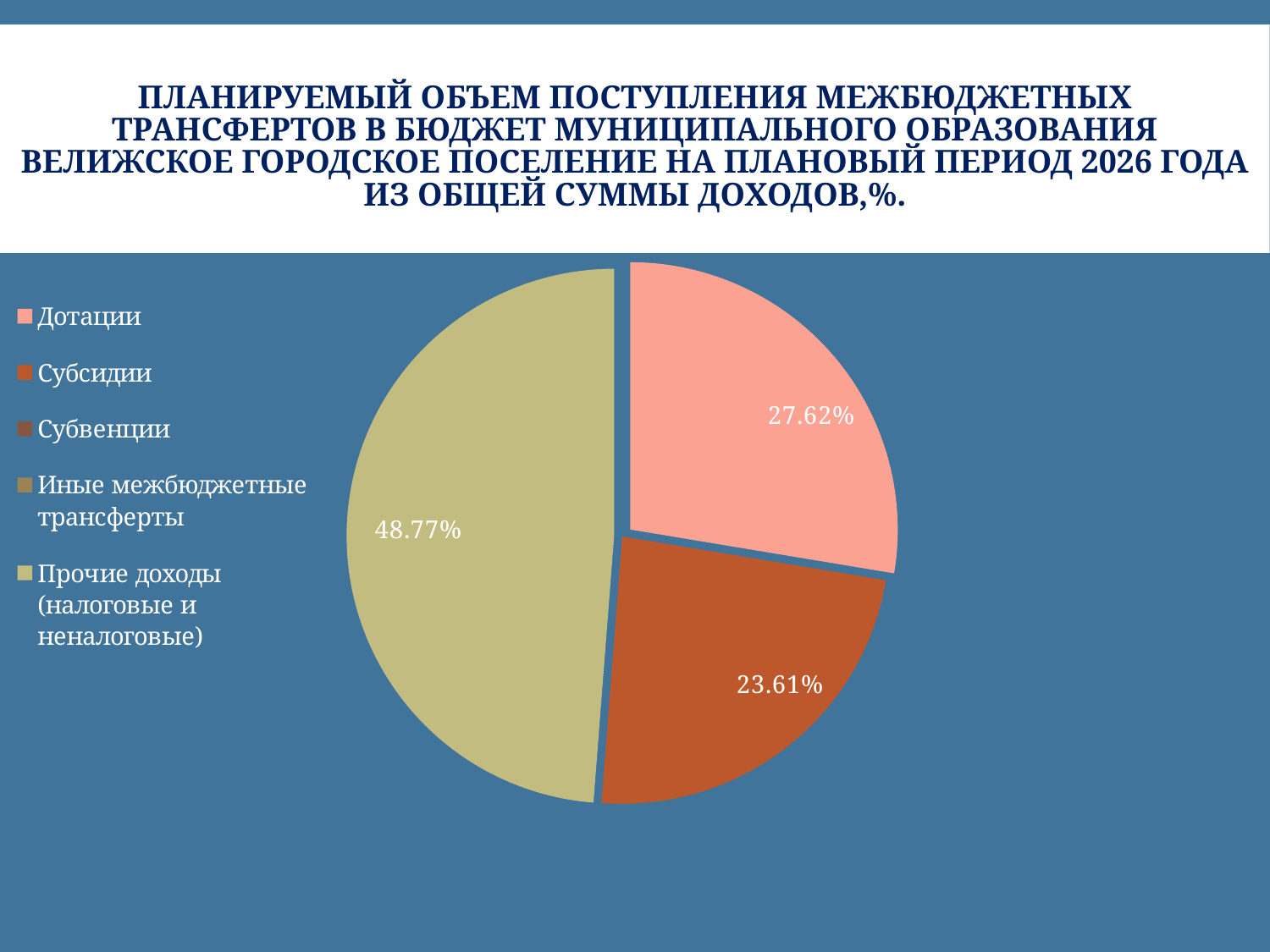
What type of chart is shown on the slide? Pie chart What percentage does the Дотации slice show? 27.62% What percentage does the Прочие доходы (налоговые и неналоговые) slice show? 48.77% What is the difference between the Дотации share and the Субсидии share? 4.01% Which is larger, the Дотации slice or the Субсидии slice? Дотации Is the Прочие доходы share greater or less than 50%? less How many slices with data labels are visible in the pie? 3 What is the difference between the Прочие доходы share and the Дотации share? 21.15% What colour is the Дотации slice? Pink What percentage does the Субсидии slice show? 23.61% How many entries does the legend list? 5 Which category has the largest slice of the pie? Прочие доходы (налоговые и неналоговые)